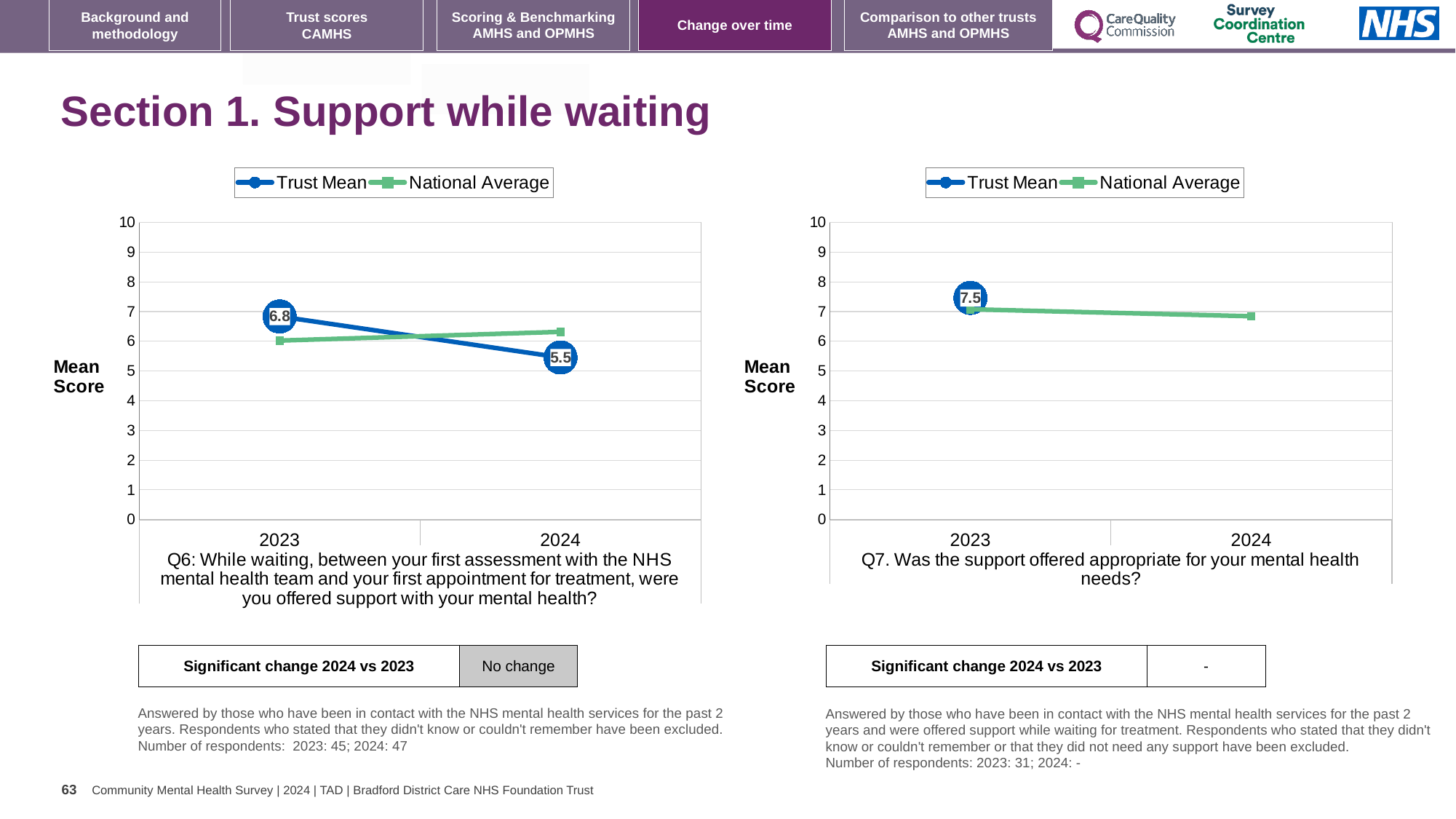
In the Q6 chart on the left, what is the Trust Mean score for 2024? 5.5 In the Q7 chart on the right, what is the Trust Mean score for 2023? 7.5 In the Q6 chart on the left, which is higher in 2023, the Trust Mean or the National Average? Trust Mean In the Q6 chart on the left, which is higher in 2024, the Trust Mean or the National Average? National Average What is the label on the vertical axis of the Q7 chart on the right? Mean Score In the Q7 chart on the right, is the National Average for 2024 greater or less than 6? greater What type of chart is the Q6 chart on the left? line chart In the Q6 chart on the left, by how much did the Trust Mean change from 2023 to 2024? 1.3 In the Q6 chart on the left, is the National Average for 2023 greater or less than 7? less In the Q6 chart on the left, what is the Trust Mean score for 2023? 6.8 In the Q6 chart on the left, does the Trust Mean rise or fall from 2023 to 2024? fall How many series does the legend of the Q7 chart on the right list? 2